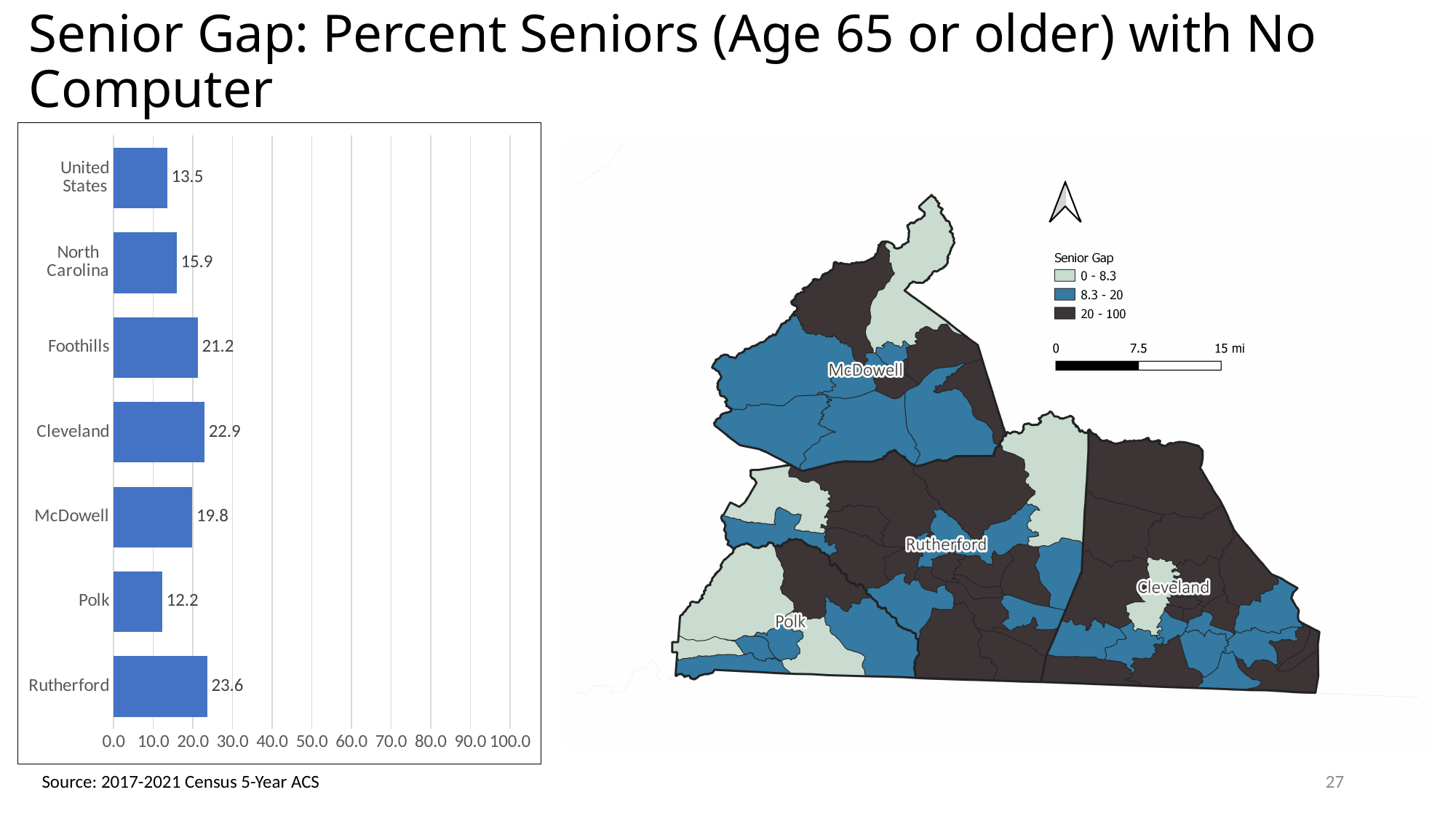
What is the value for the United States in the bar chart? 13.5 What is the difference between the values for Rutherford and the United States in the bar chart? 10.1 What type of chart is shown on the left of the slide? Bar chart Is the value for Cleveland in the bar chart greater or less than 20.0? greater Which category has the lowest value in the bar chart? Polk What is the value for North Carolina in the bar chart? 15.9 What is the value for Rutherford in the bar chart? 23.6 Which has a larger value in the bar chart, Foothills or North Carolina? Foothills Which category has the highest value in the bar chart? Rutherford What is the difference between the values for Cleveland and McDowell in the bar chart? 3.1 How many categories are shown in the bar chart? 7 What is the value for Polk in the bar chart? 12.2